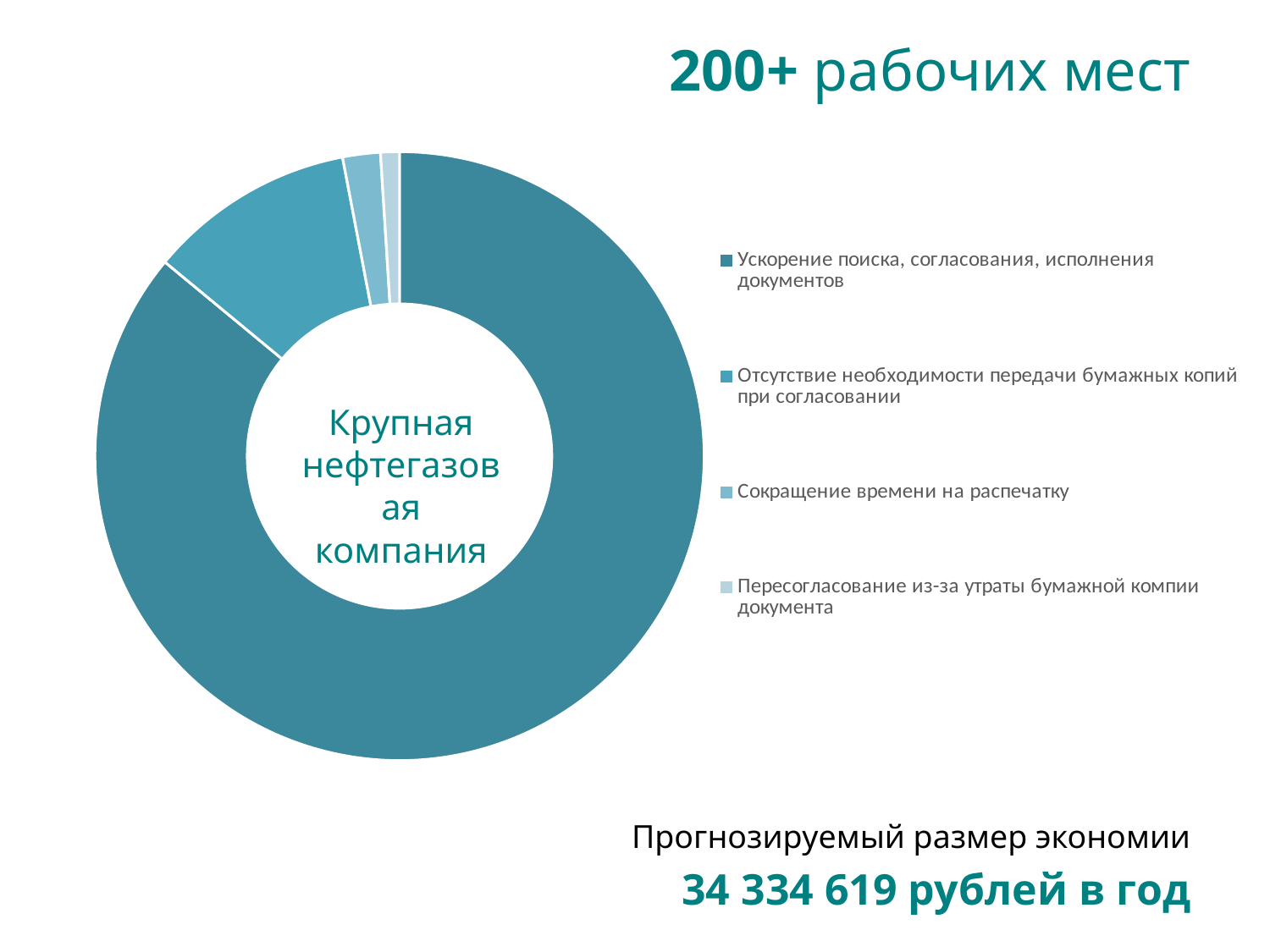
Which slice is larger: "Ускорение поиска, согласования, исполнения документов" or "Отсутствие необходимости передачи бумажных копий при согласовании"? Ускорение поиска, согласования, исполнения документов Which slice is larger: "Сокращение времени на распечатку" or "Пересогласование из-за утраты бумажной компии документа"? Сокращение времени на распечатку What text is written in the centre of the doughnut chart? Крупная нефтегазовая компания How many entries does the legend of the chart list? 4 Which category has the largest slice in the chart? Ускорение поиска, согласования, исполнения документов What is the third entry listed in the chart's legend? Сокращение времени на распечатку Which category has the smallest slice in the chart? Пересогласование из-за утраты бумажной компии документа Which slice is larger: "Отсутствие необходимости передачи бумажных копий при согласовании" or "Сокращение времени на распечатку"? Отсутствие необходимости передачи бумажных копий при согласовании What kind of chart is shown on the slide? Doughnut (pie) chart How many slices does the doughnut chart have? 4